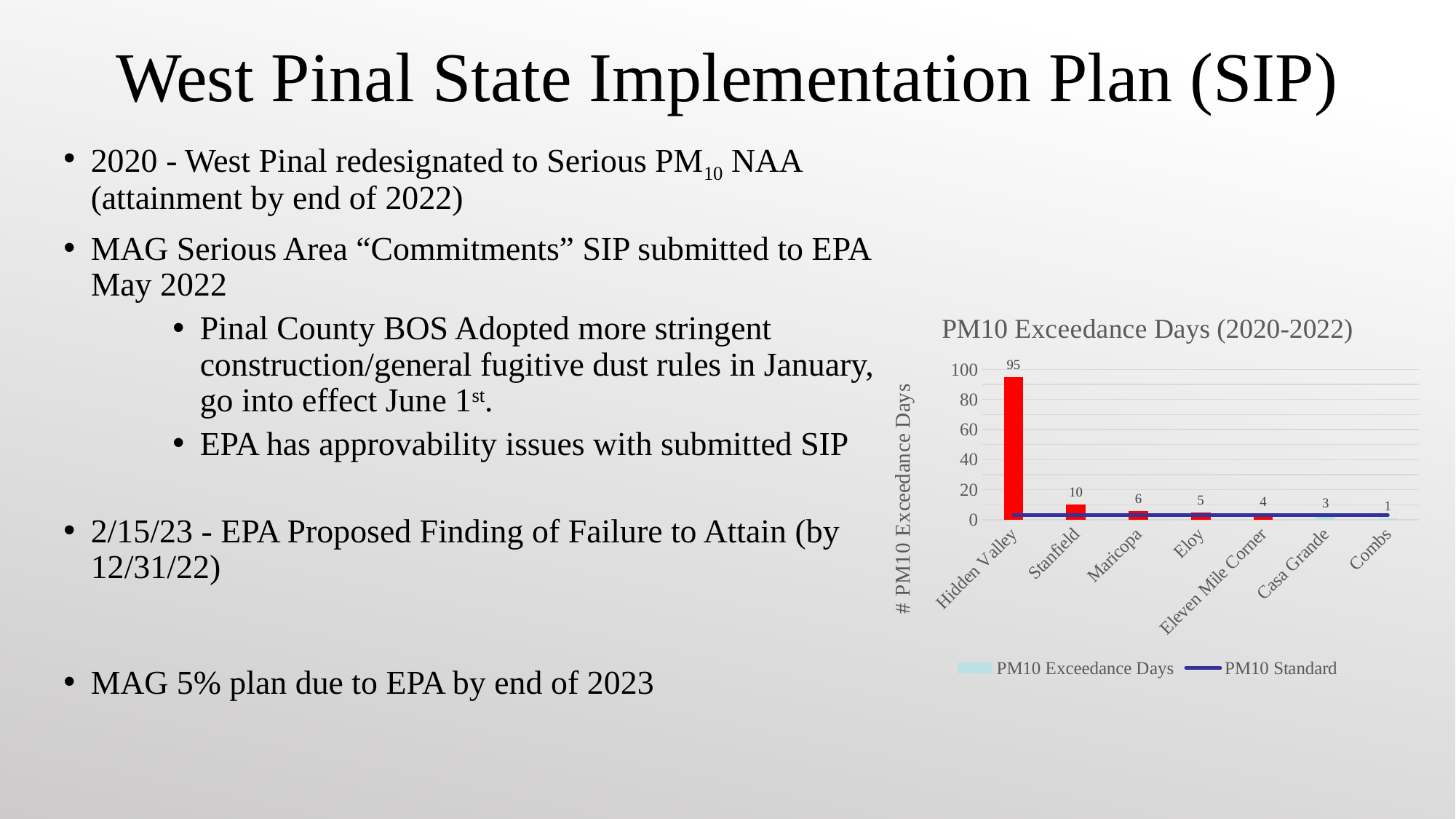
What kind of chart is used to show the PM10 exceedance days? Bar chart How many series does the chart legend list? 2 How many locations are shown on the x axis of the chart? 7 What is the title of the chart? PM10 Exceedance Days (2020-2022) Which location has the highest number of PM10 exceedance days? Hidden Valley How many PM10 exceedance days are shown for Stanfield? 10 Is the value for Hidden Valley greater or less than 80? greater Which has more PM10 exceedance days, Maricopa or Casa Grande? Maricopa How many PM10 exceedance days are shown for Hidden Valley? 95 What is the difference in PM10 exceedance days between Hidden Valley and Stanfield? 85 How many PM10 exceedance days are shown for Eleven Mile Corner? 4 Which location has the lowest number of PM10 exceedance days? Combs